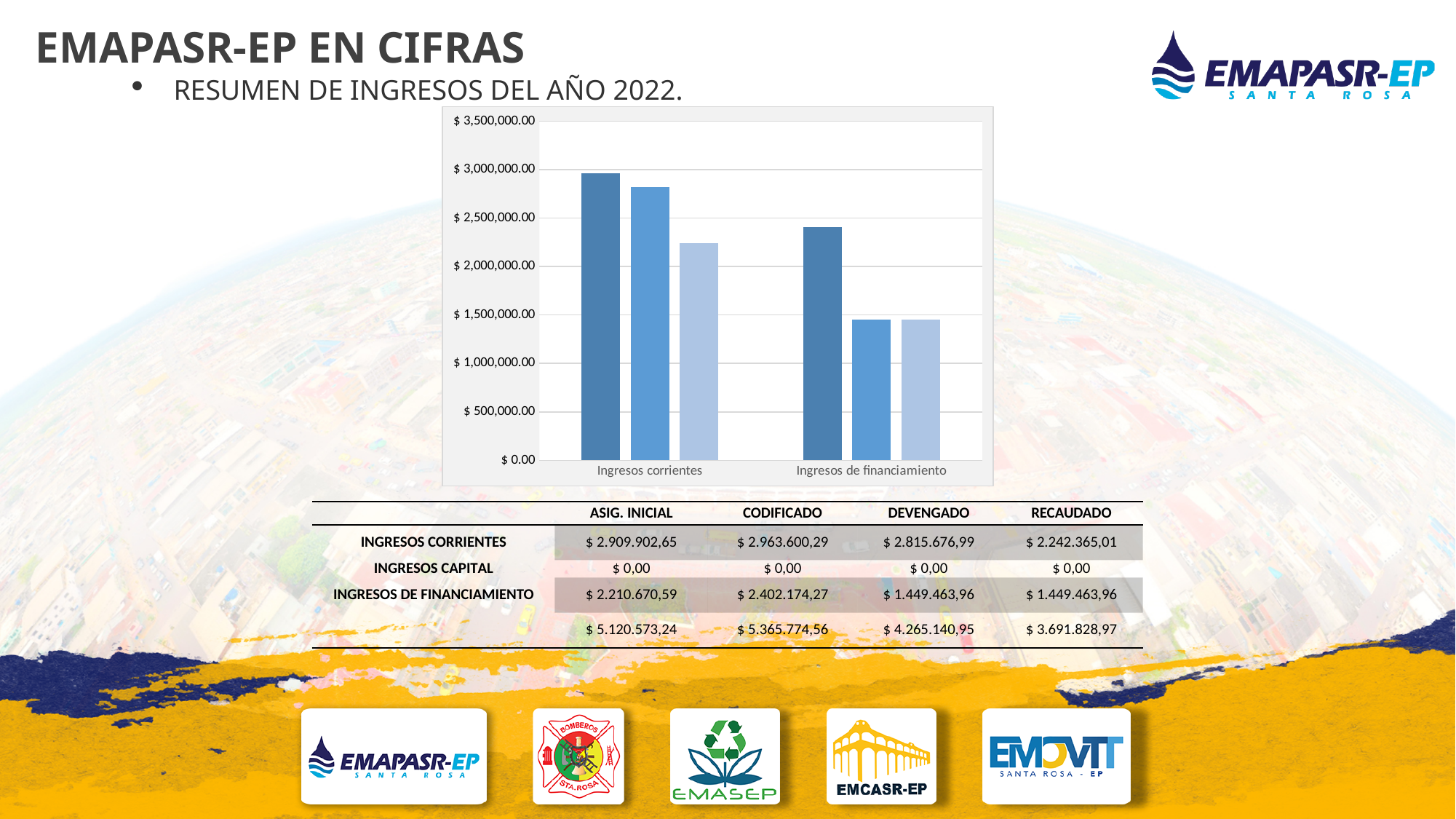
Which category contains the shortest bar in the chart? Ingresos de financiamiento Is the tallest bar for Ingresos corrientes greater or less than $ 2,500,000.00? greater Is the shortest bar for Ingresos corrientes greater or less than $ 2,500,000.00? less How many categories are shown on the x axis of the chart? 2 Which category contains the tallest bar in the chart? Ingresos corrientes Is the tallest bar for Ingresos de financiamiento greater or less than $ 2,000,000.00? greater How many bars are plotted for each category in the chart? 3 What kind of chart is shown on the slide? Bar chart Within the Ingresos corrientes category, do the three bars rise or fall from left to right? Fall What is the highest value labelled on the chart's y axis? $ 3,500,000.00